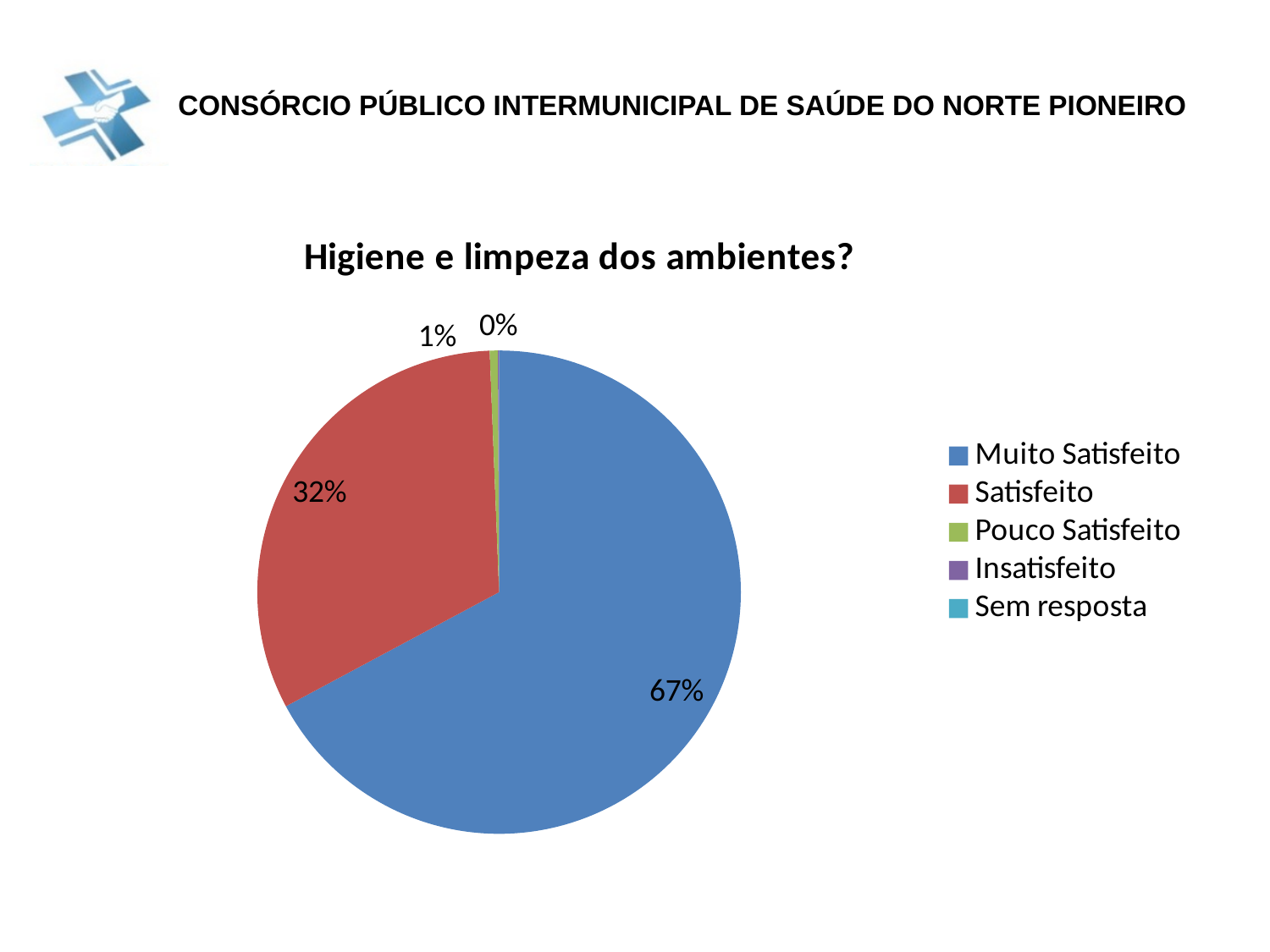
Which category has the largest slice of the pie chart? Muito Satisfeito Which is larger, the share for "Satisfeito" or the share for "Pouco Satisfeito"? Satisfeito What type of chart is shown on the slide? Pie chart What share of the pie chart corresponds to "Satisfeito"? 32% How many categories are listed in the chart's legend? 5 What percentage is shown for "Pouco Satisfeito"? 1% What is the difference in percentage points between "Muito Satisfeito" and "Satisfeito"? 35 percentage points Do "Muito Satisfeito" and "Satisfeito" together account for more or less than 90% of the pie? more What colour is the "Satisfeito" slice in the pie chart? Red Is the share for "Muito Satisfeito" greater or less than 50%? greater What is the title of the chart? Higiene e limpeza dos ambientes? What percentage of respondents answered "Muito Satisfeito" in the pie chart? 67%